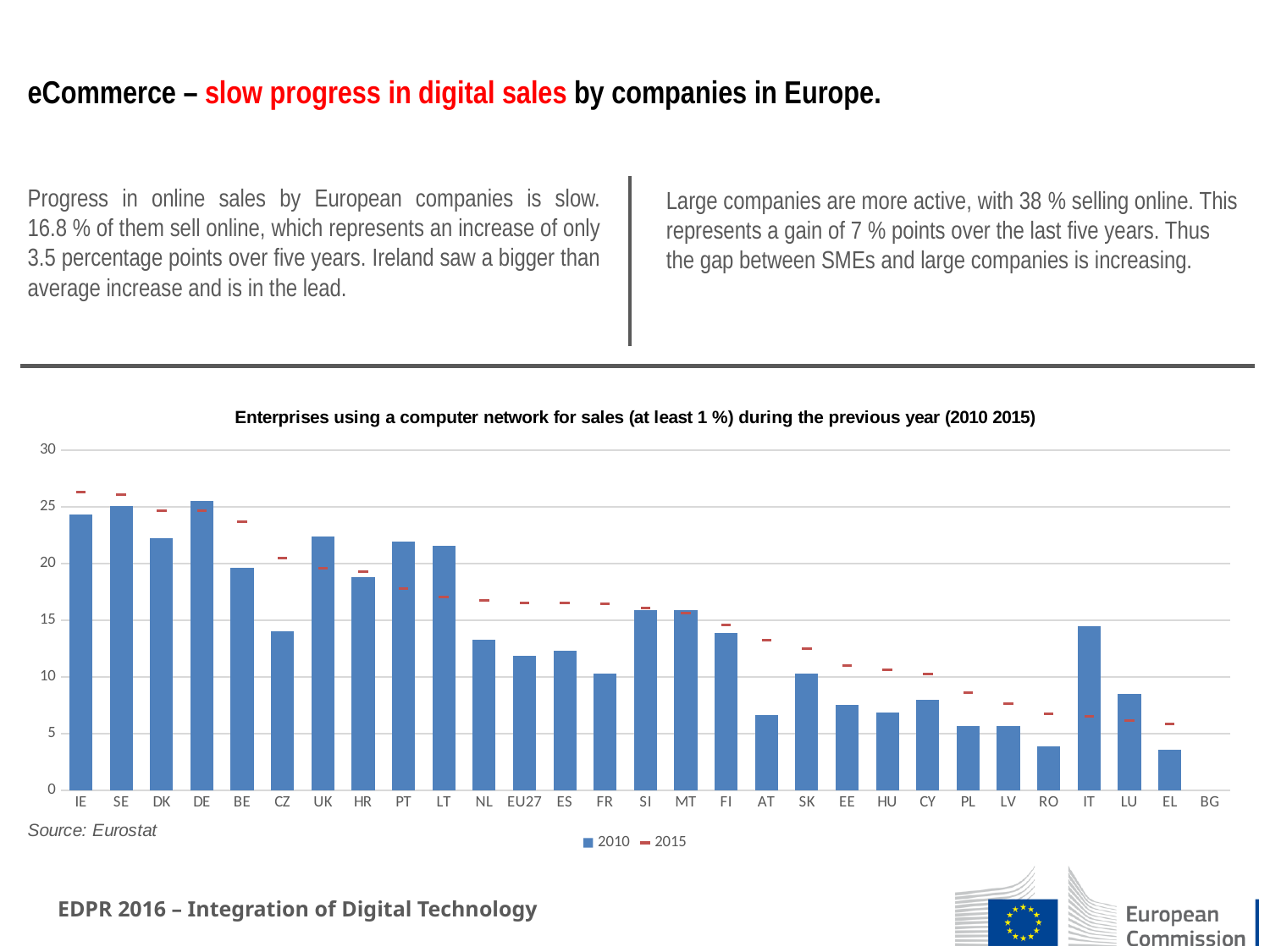
Is the 2010 value for CZ greater or less than 15? less Is the 2010 value for NL greater or less than 10? greater Is the 2015 value for IE greater or less than 25? greater Do the 2015 values generally rise or fall moving from left to right along the x axis? fall Which has the larger 2010 value, IT or LU? IT What kind of chart is shown on the slide? bar chart Which has the larger 2010 value, UK or CZ? UK How many series does the chart legend list? 2 How many countries/categories are shown on the x axis of the chart? 29 Which series is shown by the red dash markers in the chart? 2015